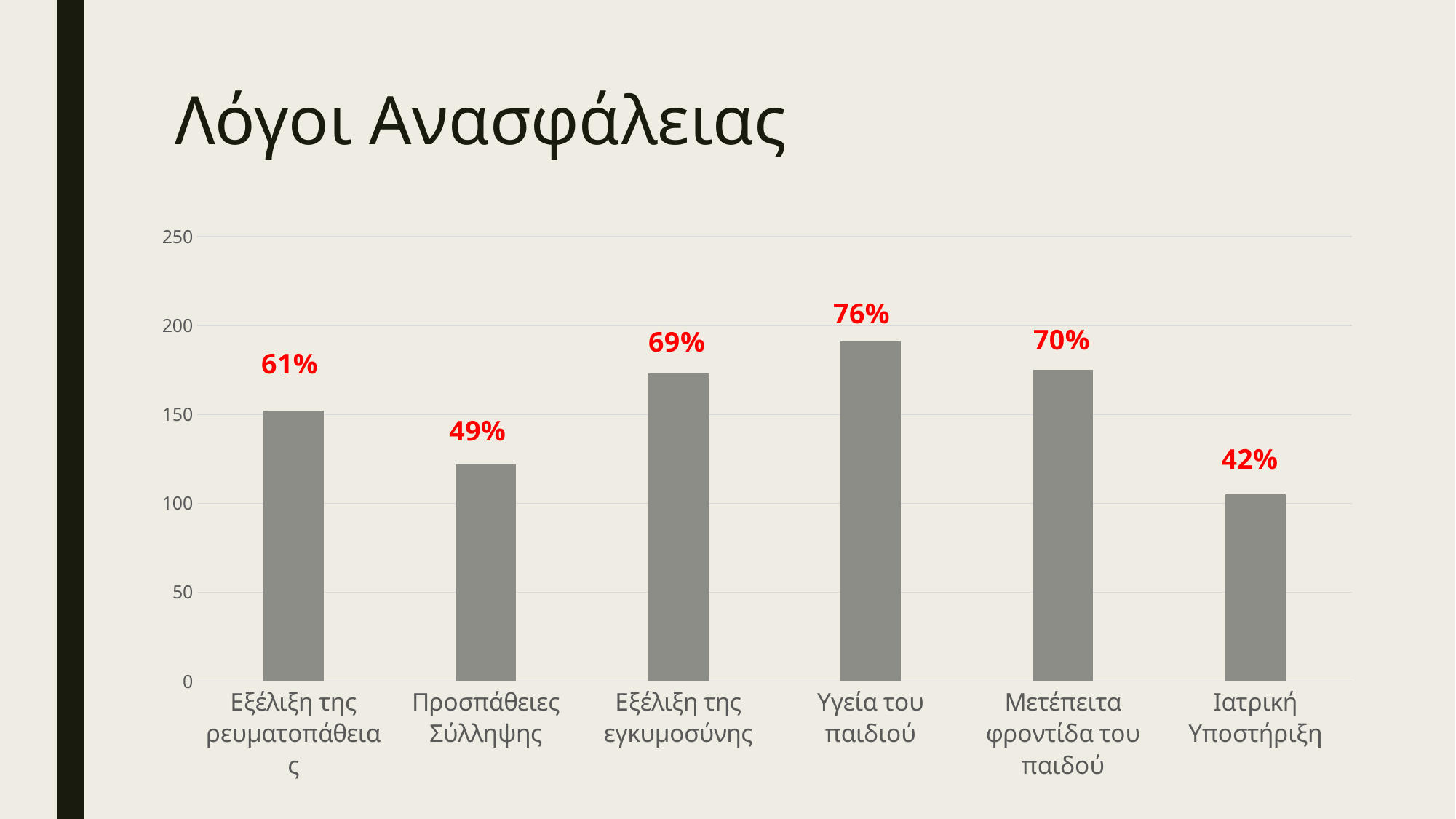
What percentage label is shown for Υγεία του παιδιού? 76% What percentage label is shown for Μετέπειτα φροντίδα του παιδού? 70% What is the difference in percentage points between the labels for Υγεία του παιδιού and Ιατρική Υποστήριξη? 34% What is the title of the slide? Λόγοι Ανασφάλειας Is the bar for Ιατρική Υποστήριξη greater or less than 100 on the vertical axis? greater Is the bar for Προσπάθειες Σύλληψης greater or less than 150 on the vertical axis? less How many categories are shown in the chart? 6 Which has the larger percentage label, Εξέλιξη της εγκυμοσύνης or Μετέπειτα φροντίδα του παιδού? Μετέπειτα φροντίδα του παιδού Which category has the lowest value? Ιατρική Υποστήριξη What percentage label is shown for Προσπάθειες Σύλληψης? 49% What kind of chart is shown on the slide? bar chart Which category has the highest value? Υγεία του παιδιού